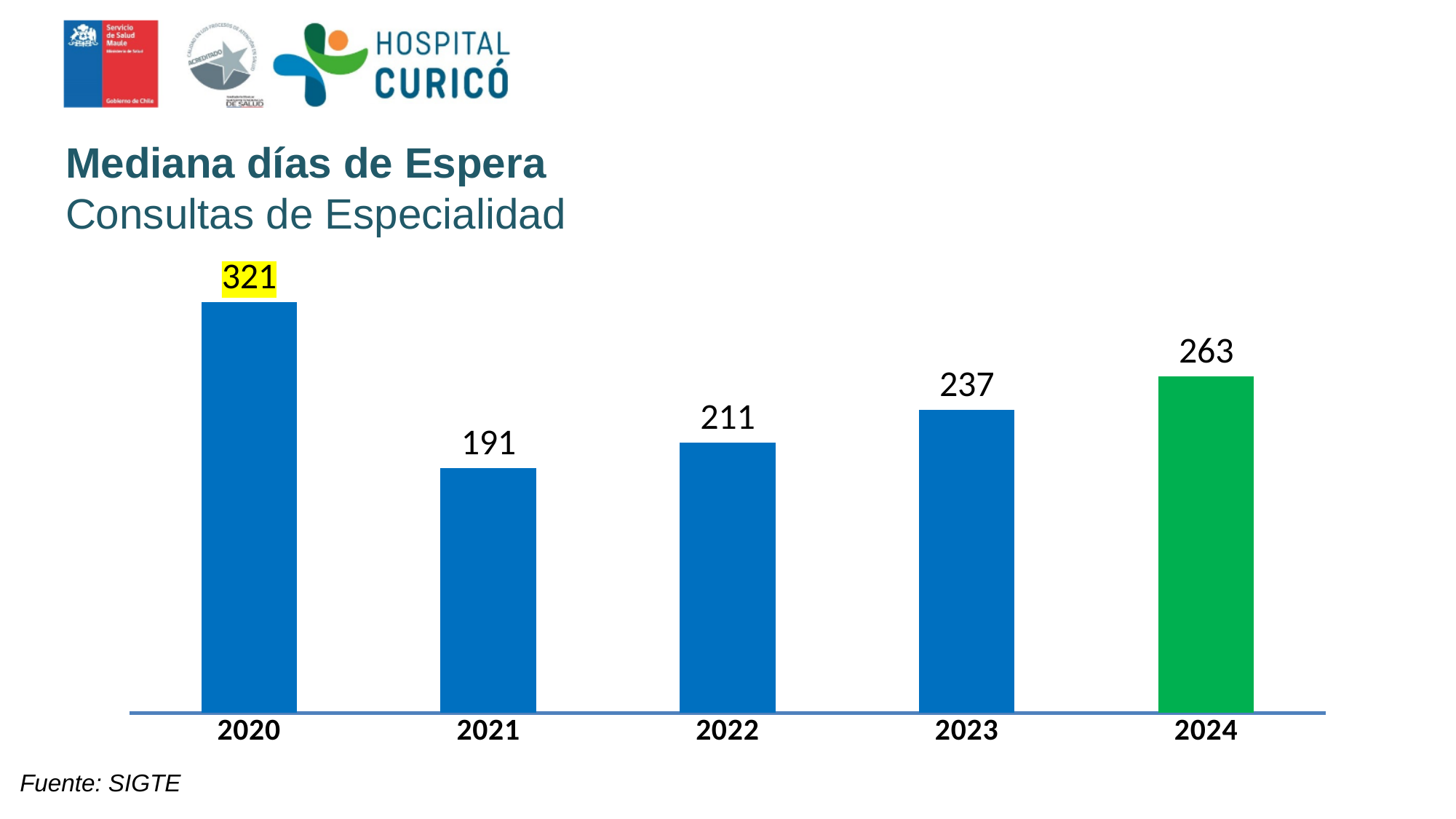
Which year has the lowest median waiting days? 2021 How many years are shown on the x axis? 5 Do the values rise or fall from 2021 to 2024? Rise What is the value shown for 2021? 191 What is the value shown for 2024? 263 What is the difference between the values for 2024 and 2023? 26 Which bar is coloured green instead of blue? 2024 What is the difference between the values for 2020 and 2021? 130 Which year has the highest median waiting days? 2020 What kind of chart is shown on the slide? Bar chart Which is larger, the value for 2022 or the value for 2023? 2023 What is the median waiting days value for 2020? 321